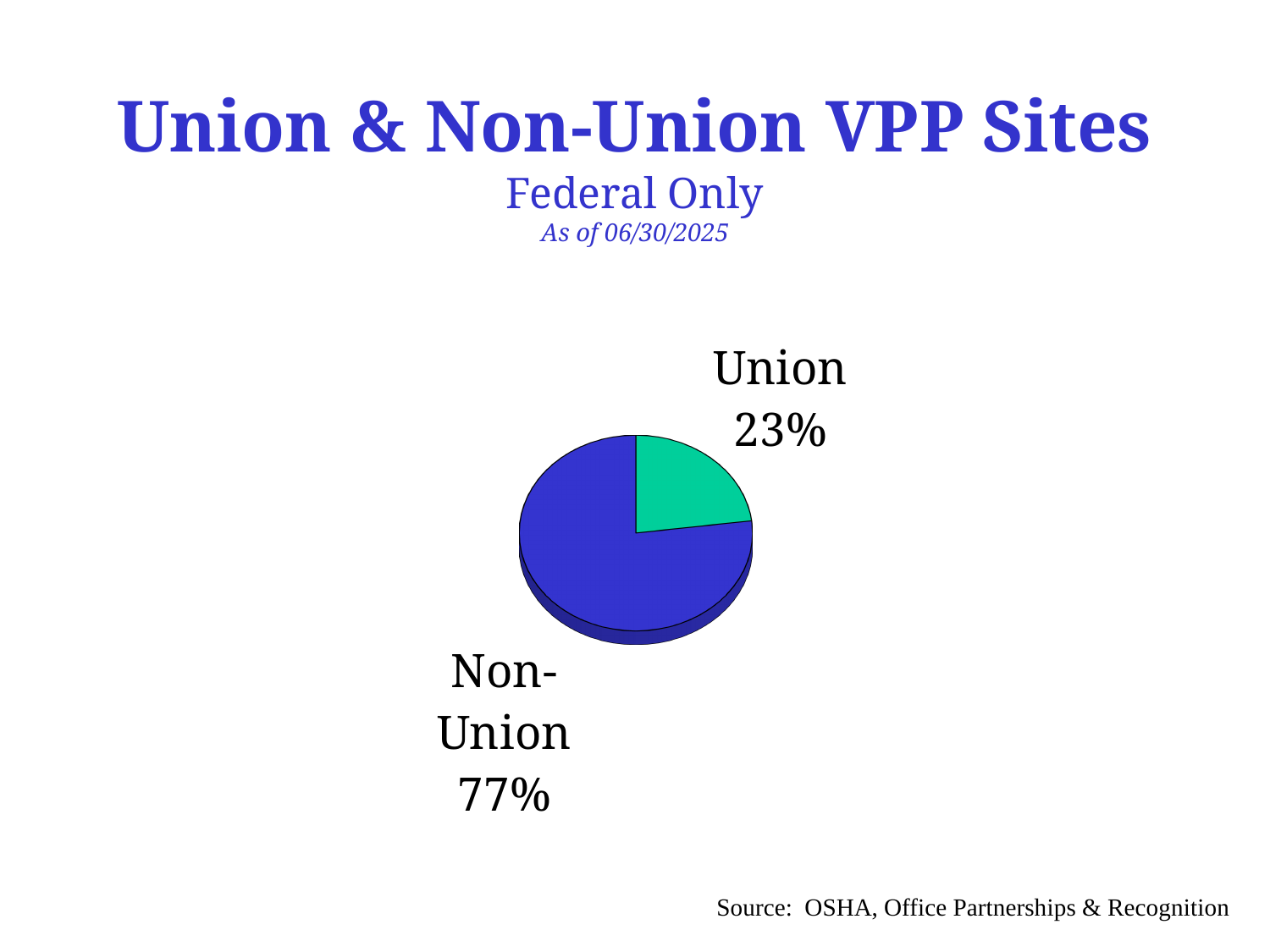
What share of the pie does the Union slice represent? 23% Which is larger, the Union share or the Non-Union share? Non-Union What colour is the Union slice of the pie? Green What kind of chart is shown on the slide? Pie chart What is the difference in percentage points between the Non-Union and Union shares? 54 How many slices does the pie chart have? 2 What percentage of federal VPP sites are Union? 23% Which category has the largest share of the pie? Non-Union What is the title of the chart on the slide? Union & Non-Union VPP Sites Which category has the smallest share of the pie? Union What percentage of federal VPP sites are Non-Union? 77%